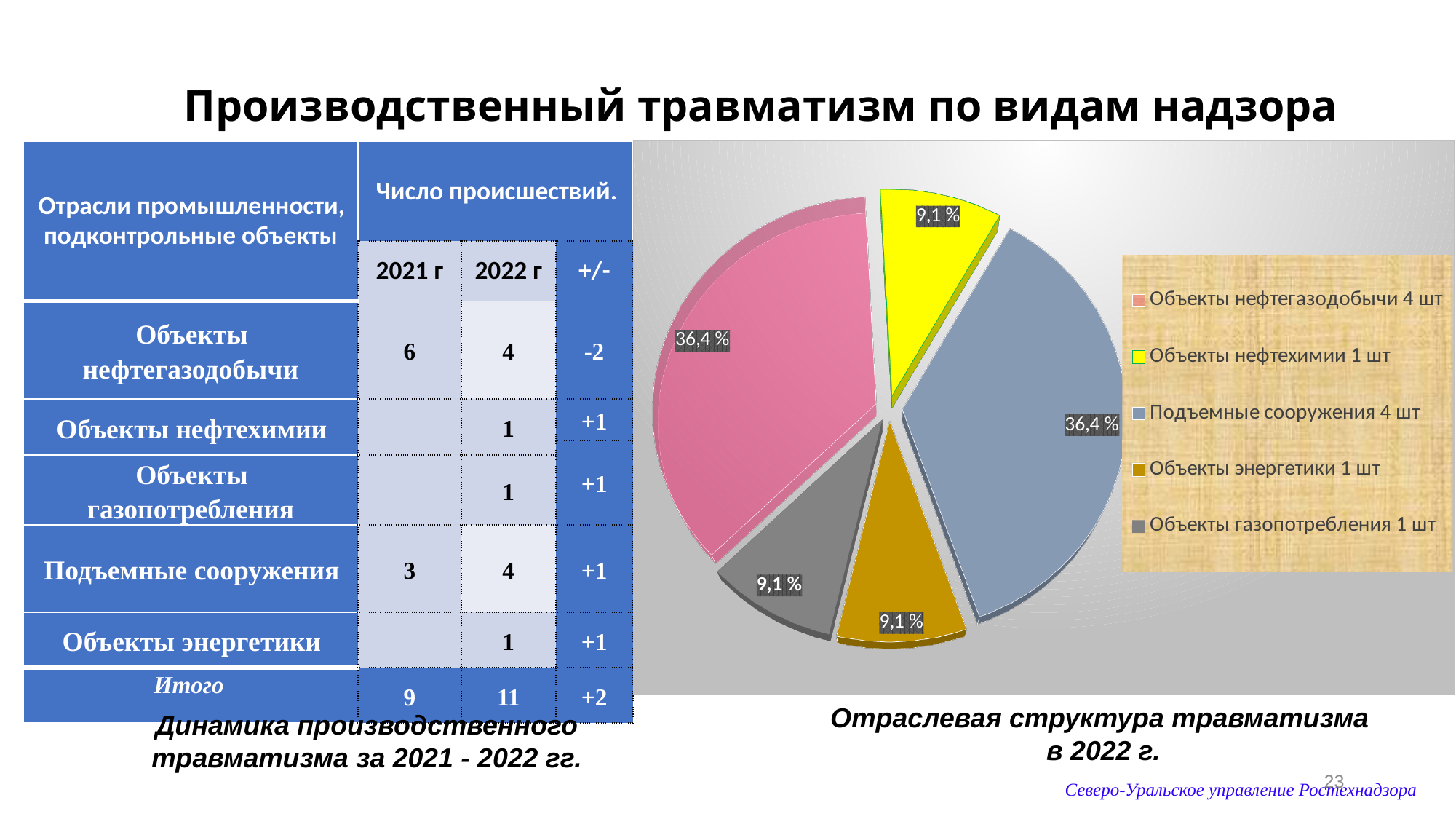
According to the legend, how many incidents (шт) are attributed to Подъемные сооружения? 4 шт What is the difference in percentage points between the Подъемные сооружения slice and the Объекты энергетики slice? 27,3 % What share of the pie chart does Объекты энергетики have? 9,1 % How many slices does the pie chart have? 5 What share of the pie chart does Объекты нефтегазодобычи have? 36,4 % Which slice is larger: Объекты нефтегазодобычи or Объекты газопотребления? Объекты нефтегазодобычи What share of the pie chart does Объекты нефтехимии have? 9,1 % What share of the pie chart does Подъемные сооружения have? 36,4 % What colour is the Объекты нефтехимии slice in the pie chart? yellow What kind of chart is shown on the slide? pie chart How many slices of the pie chart are labelled 9,1 %? 3 What is the title of the pie chart? Отраслевая структура травматизма в 2022 г.